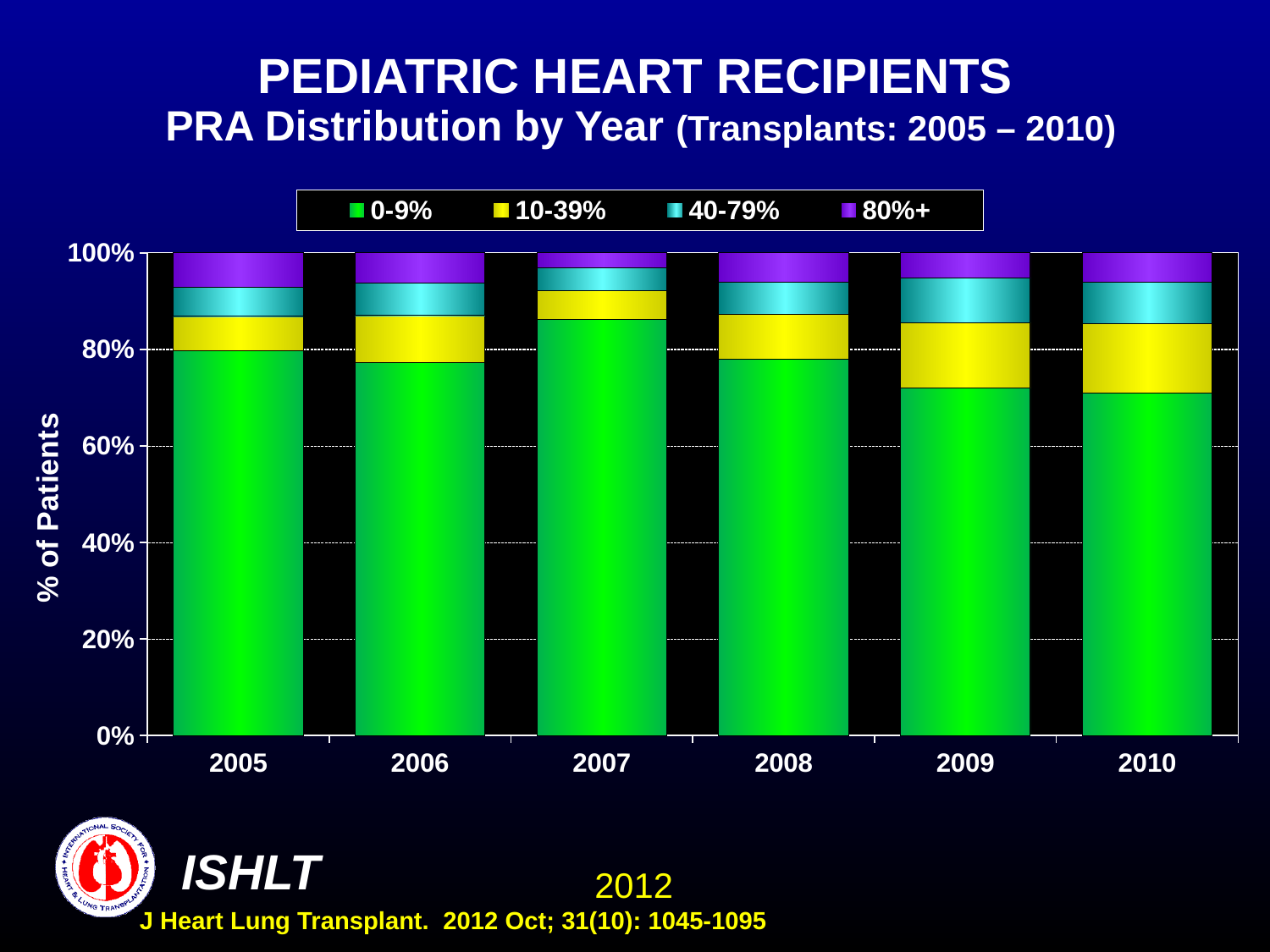
How many years are shown along the x axis? 6 Which year has the largest 0-9% segment? 2007 Is the 0-9% segment for 2009 greater or less than 80%? less Is the 0-9% segment for 2007 greater or less than 80%? greater How many series does the legend list? 4 What does each stacked bar total? 100% Is the 0-9% segment for 2007 larger in 2007 or in 2010? 2007 Is the 0-9% segment for 2010 greater or less than 80%? less Which legend entry is shown in purple? 80%+ What is the label on the y axis? % of Patients What kind of chart is shown on the slide? stacked bar chart